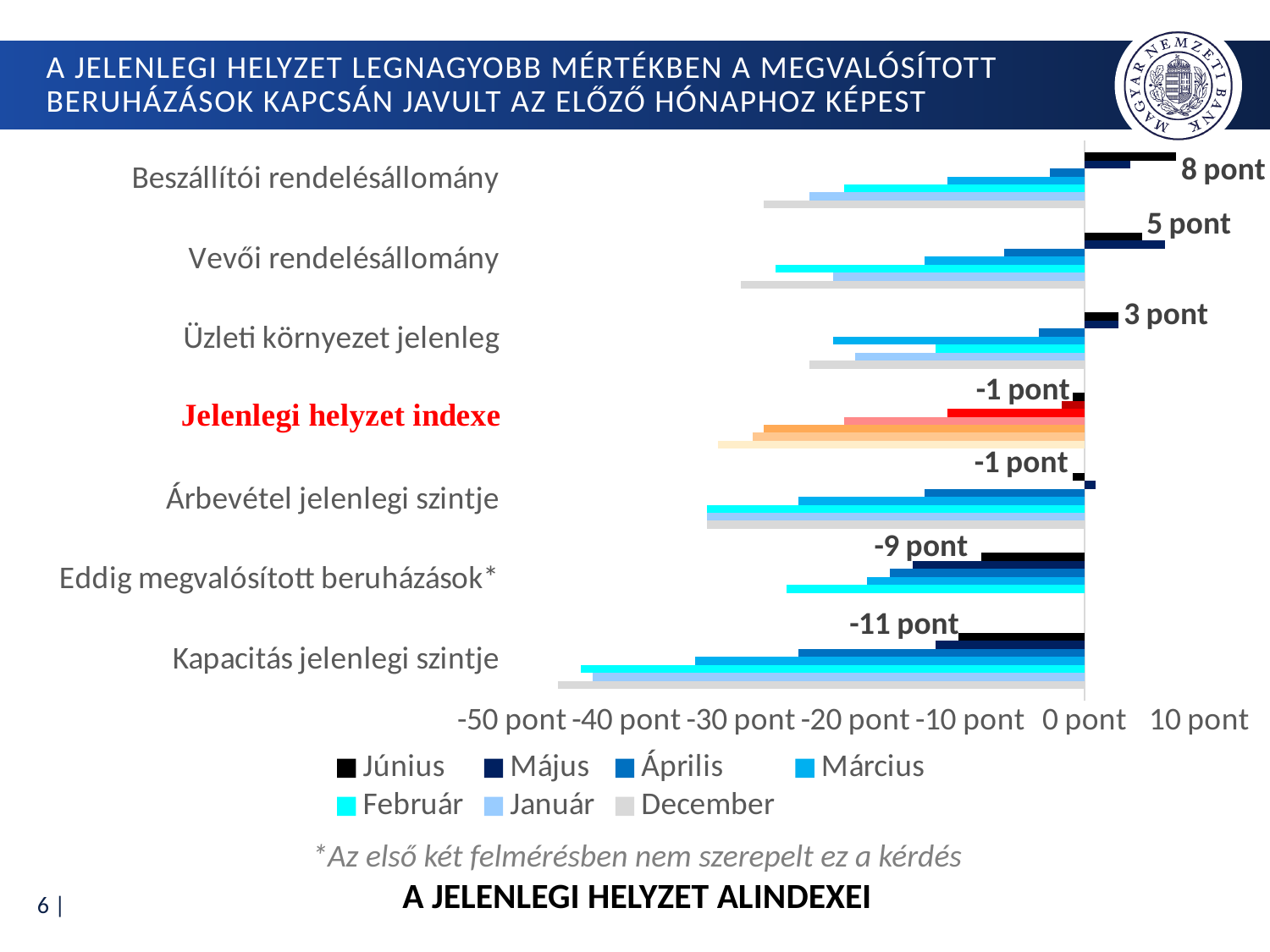
What is the Június value for Eddig megvalósított beruházások*? -9 pont What is the Június value for Üzleti környezet jelenleg? 3 pont Which has the larger Június value, Vevői rendelésállomány or Üzleti környezet jelenleg? Vevői rendelésállomány Is the December value for Kapacitás jelenlegi szintje greater or less than -40 pont? less What is the Június value for Beszállítói rendelésállomány? 8 pont What is the difference between the Június values for Beszállítói rendelésállomány and Vevői rendelésállomány? 3 pont Which category has the highest Június value? Beszállítói rendelésállomány What kind of chart is shown on the slide? bar chart Which category has the lowest Június value? Kapacitás jelenlegi szintje What is the Június value for Kapacitás jelenlegi szintje? -11 pont How many series does the legend list? 7 How many categories are shown on the chart? 7